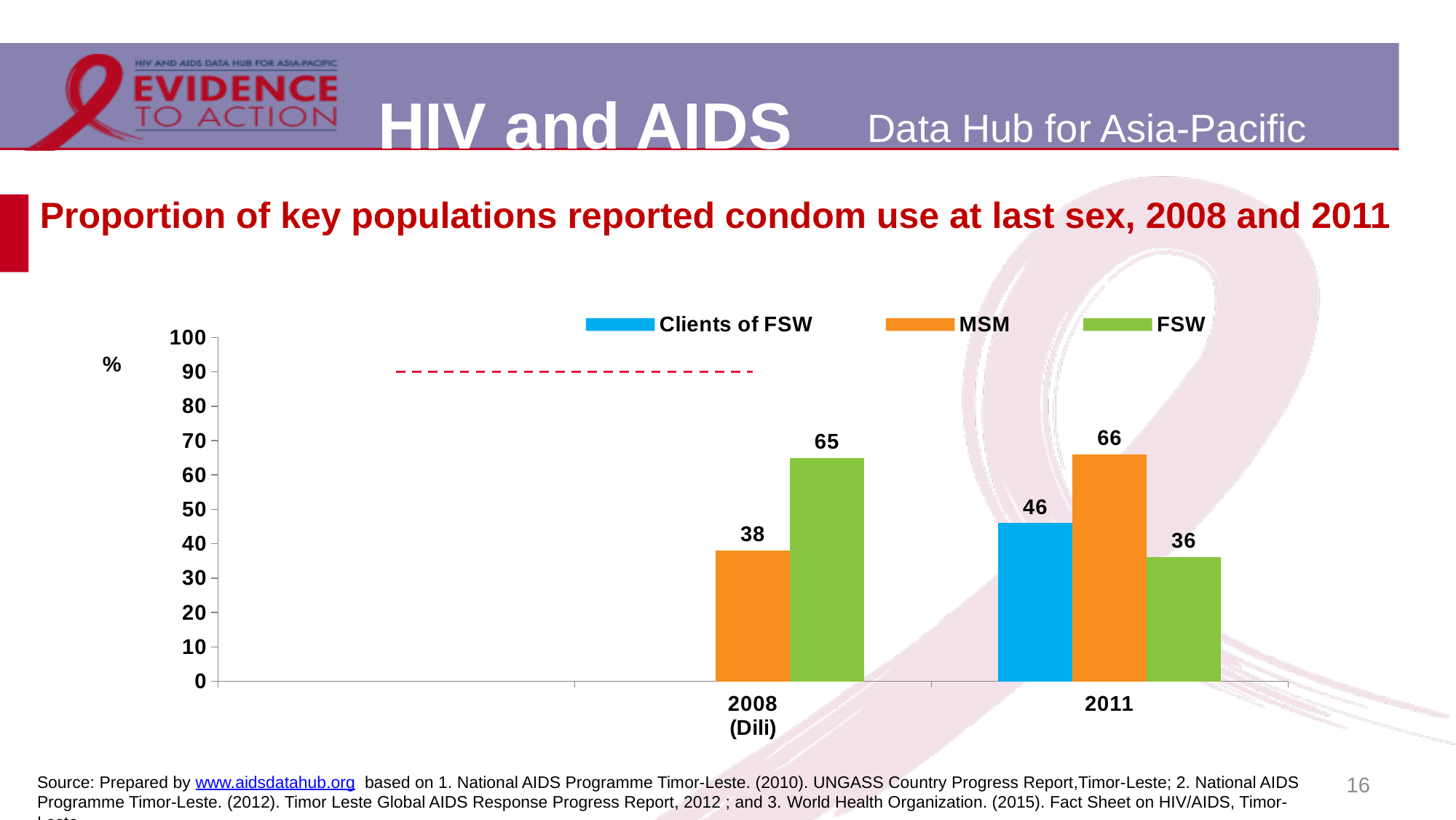
What is the value for FSW in 2008 (Dili)? 65 Does the FSW value rise or fall from 2008 (Dili) to 2011? Fall What colour represents Clients of FSW in the chart? Blue Which series has the lowest value in 2011? FSW Which is larger: the FSW value in 2008 (Dili) or the FSW value in 2011? 2008 (Dili) What is the value for MSM in 2008 (Dili)? 38 What is the value for Clients of FSW in 2011? 46 What kind of chart is shown on the slide? Bar chart What is the difference between the MSM values in 2011 and 2008 (Dili)? 28 How many series does the legend list? 3 What is the value for FSW in 2011? 36 Which series has the highest value in 2011? MSM